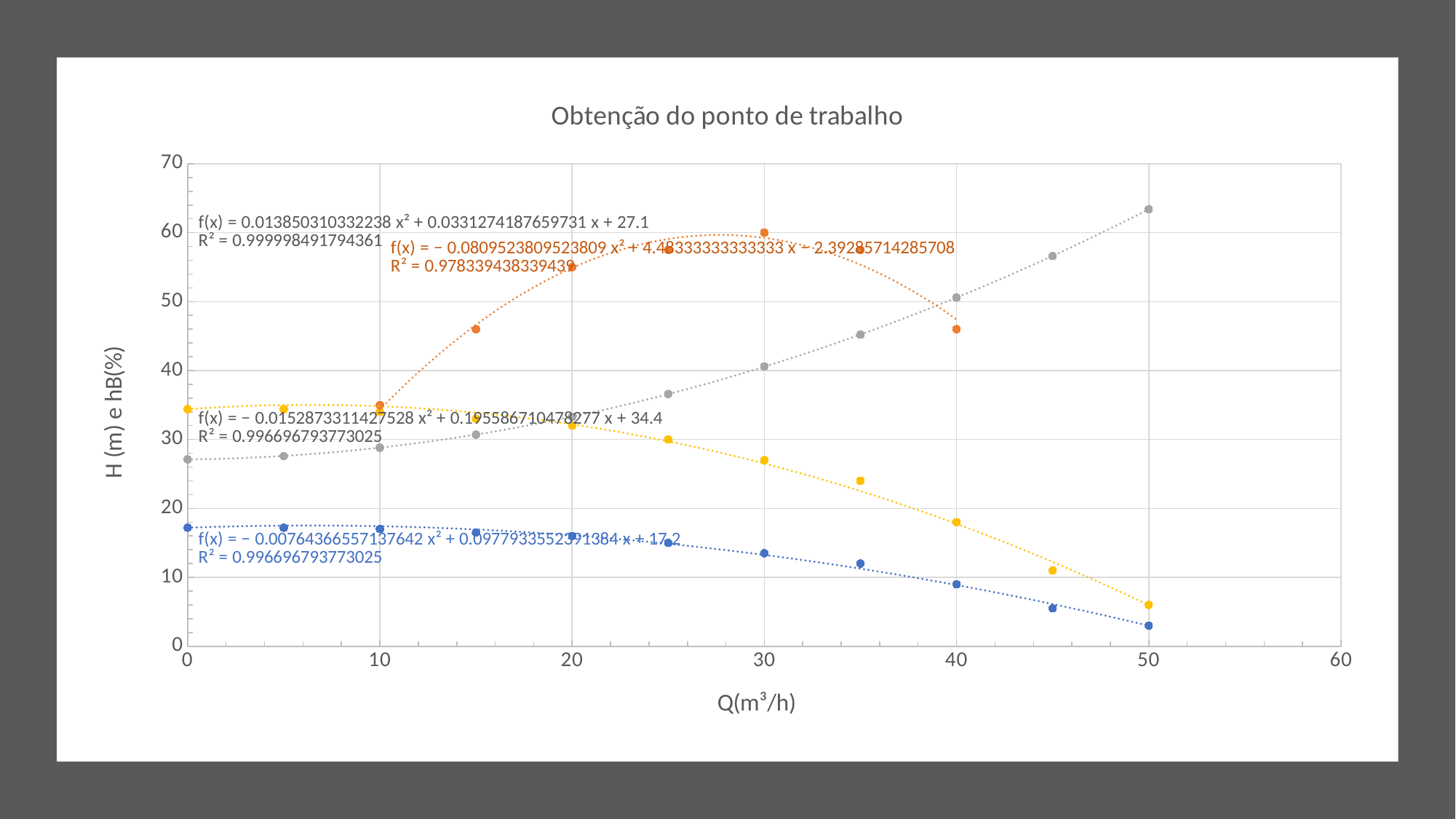
What kind of chart is shown on the slide? Scatter chart Does the yellow series rise or fall as Q increases from 20 to 50? Falls What is the title of the chart? Obtenção do ponto de trabalho Is the value of the gray series at Q = 50 greater or less than 60? greater Is the value of the yellow series at Q = 40 greater or less than 20? less Is the value of the orange series at Q = 30 greater or less than 50? greater How many data points does the orange series have? 7 At Q = 40, which series has the larger value, the orange series or the blue series? Orange series Does the gray series rise or fall as Q increases from 0 to 50? Rises What is the label on the x axis of the chart? Q(m³/h) Does the blue series rise or fall as Q increases from 10 to 50? Falls